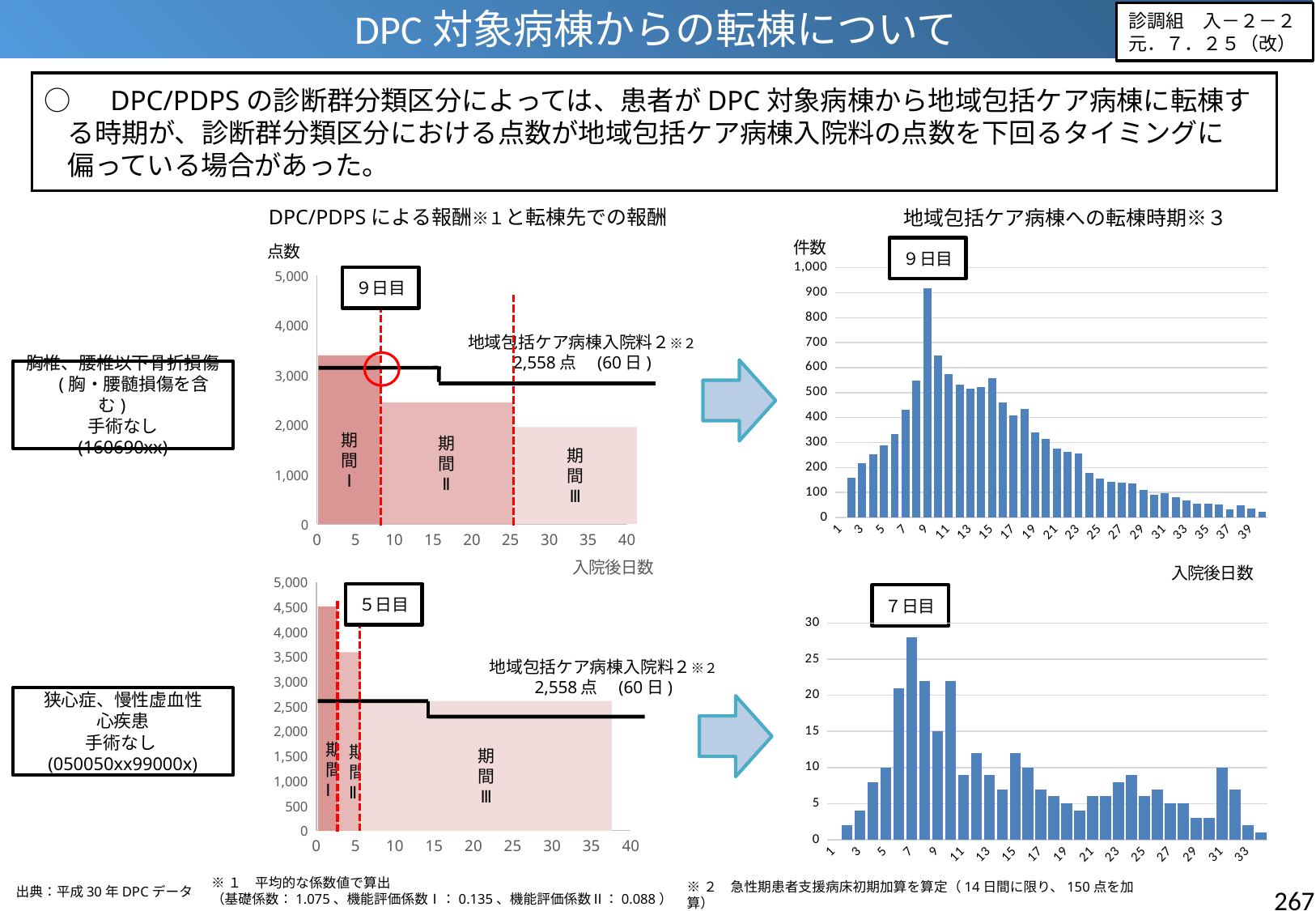
In the top-right bar chart, is the value for day 1 greater or less than 200? less In the top-right bar chart (地域包括ケア病棟への転棟時期※3), which day after admission has the highest number of cases? 9 In the top-right bar chart, which has more cases: day 9 or day 19? day 9 What is the y-axis label of the top-right bar chart? 件数 In the bottom-right bar chart, is the value for day 7 greater or less than 25? greater In the top-left chart (DPC/PDPS による報酬※1と転棟先での報酬), how many points is 地域包括ケア病棟入院料2 shown as? 2,558点 In the top-right bar chart, do the counts generally rise or fall from day 9 to day 39? fall What kind of chart is the top-right chart titled 地域包括ケア病棟への転棟時期※3? bar chart In the bottom-right bar chart, which has more cases: day 7 or day 15? day 7 In the bottom-right bar chart (for 狭心症、慢性虚血性心疾患), which day after admission has the highest number of cases? 7 In the top-right bar chart, is the value for day 9 greater or less than 800? greater